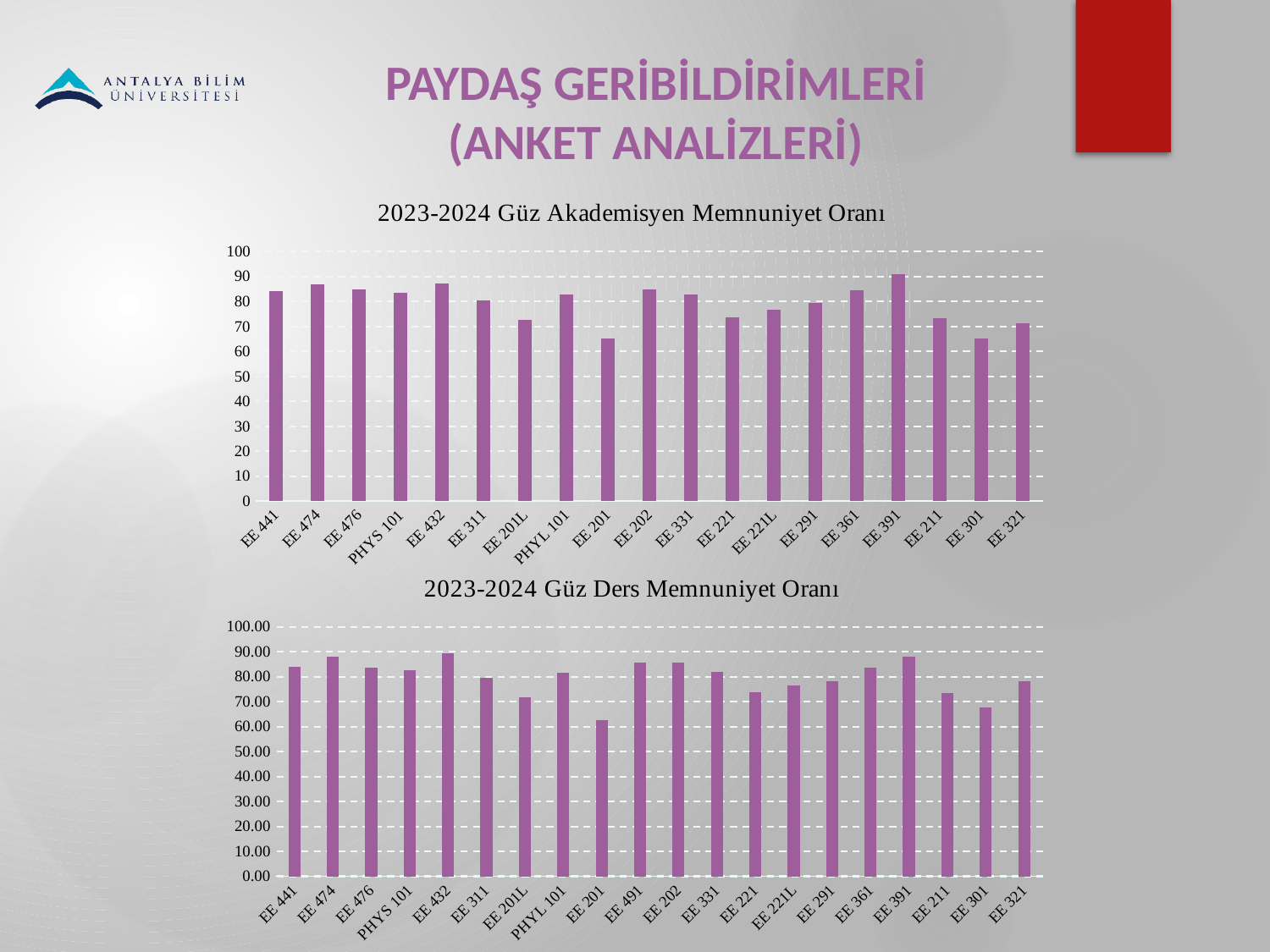
In the top chart '2023-2024 Güz Akademisyen Memnuniyet Oranı', is the value for EE 201 greater or less than 70? less What type of chart is the top chart titled '2023-2024 Güz Akademisyen Memnuniyet Oranı'? Bar chart In the bottom chart '2023-2024 Güz Ders Memnuniyet Oranı', is the value for EE 432 greater or less than 80.00? greater What is the title of the bottom chart on the slide? 2023-2024 Güz Ders Memnuniyet Oranı How many categories are shown on the bottom chart '2023-2024 Güz Ders Memnuniyet Oranı'? 20 In the top chart '2023-2024 Güz Akademisyen Memnuniyet Oranı', which is larger, the value for EE 474 or the value for EE 201? EE 474 How many categories are shown on the top chart '2023-2024 Güz Akademisyen Memnuniyet Oranı'? 19 In the bottom chart '2023-2024 Güz Ders Memnuniyet Oranı', is the value for EE 201 greater or less than 70? less In the bottom chart '2023-2024 Güz Ders Memnuniyet Oranı', which category has the lowest value? EE 201 In the bottom chart '2023-2024 Güz Ders Memnuniyet Oranı', which is larger, the value for EE 441 or the value for EE 301? EE 441 In the top chart '2023-2024 Güz Akademisyen Memnuniyet Oranı', which category has the highest value? EE 391